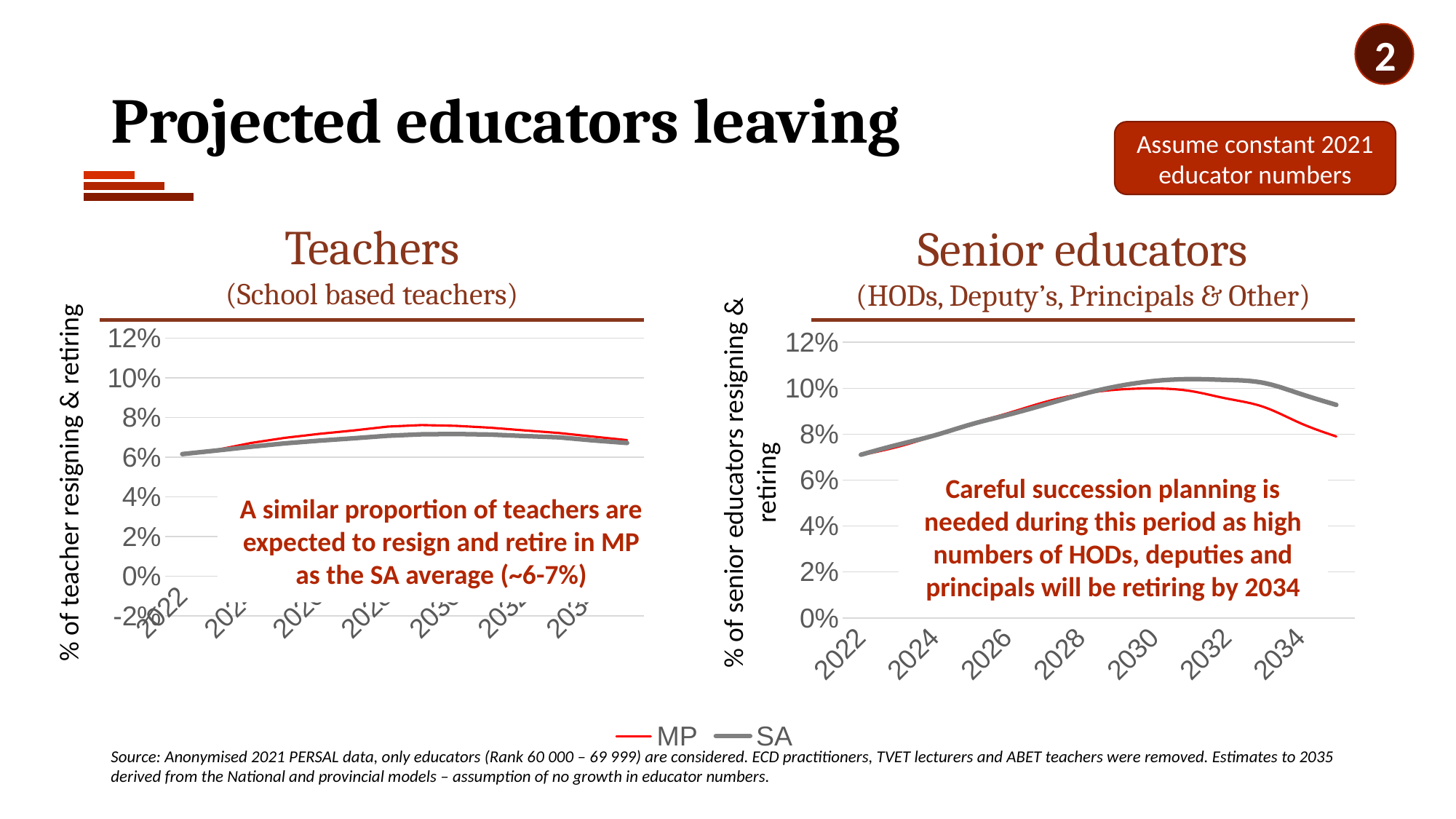
In the Senior educators chart, is the value for SA in 2034 greater or less than 8%? greater What type of chart is the Senior educators chart? line chart What is the subtitle shown under the Senior educators chart title? (HODs, Deputy's, Principals & Other) What type of chart is the Teachers chart? line chart Which two series are shown in the legend? MP and SA In the Senior educators chart, does the MP line rise or fall between 2022 and 2030? rise In the Senior educators chart, does the MP line rise or fall between 2030 and 2034? fall In the Senior educators chart, is the value for MP in 2022 greater or less than 8%? less How many series does the legend list for the charts? 2 In the Teachers chart, is the value for SA in 2022 greater or less than 4%? greater In the Senior educators chart, which series has the higher value in 2034, MP or SA? SA